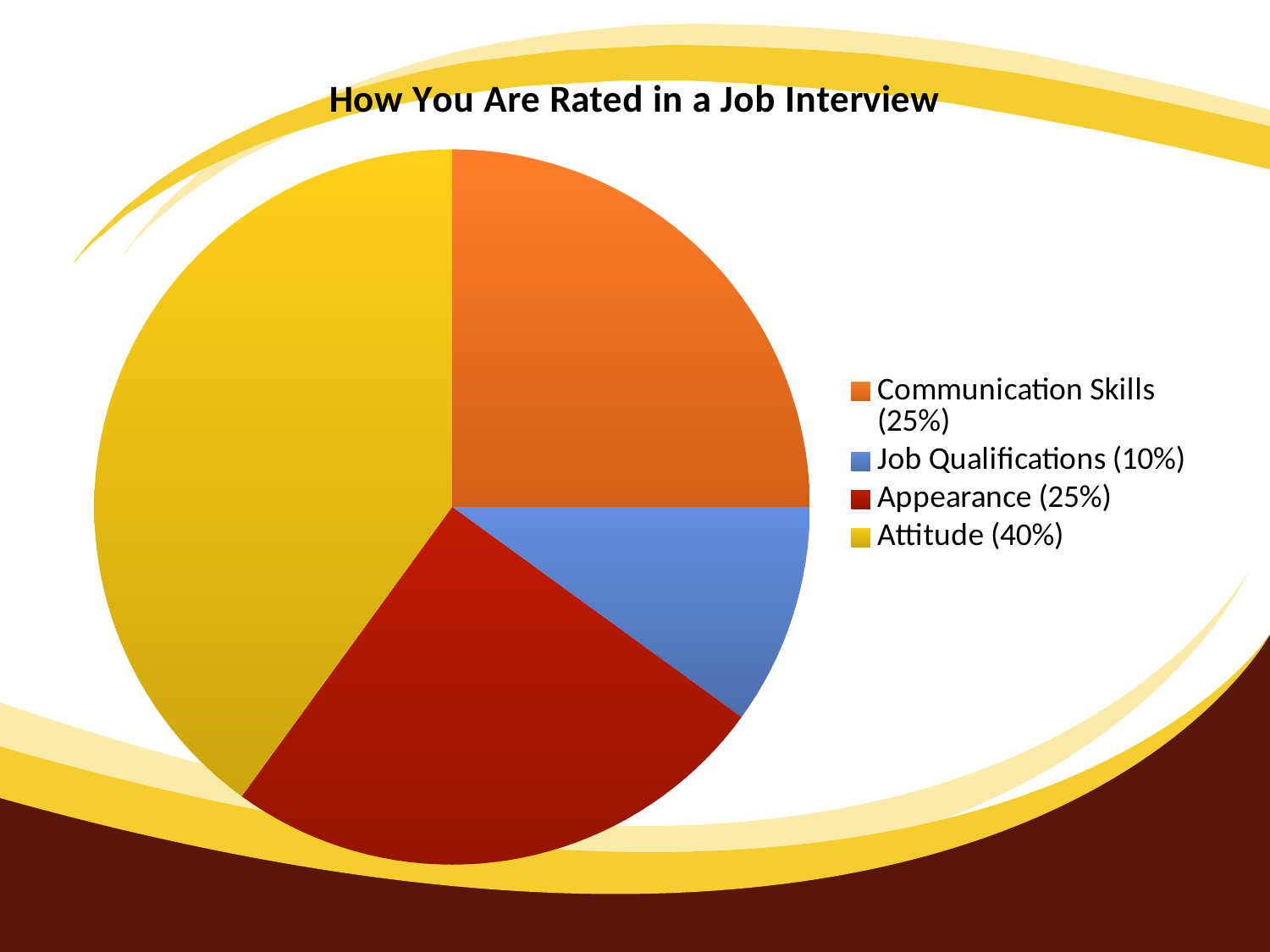
What is the title of the chart? How You Are Rated in a Job Interview How many slices does the pie chart have? 4 What type of chart is shown on the slide? Pie chart What is the difference in percentage points between Attitude and Job Qualifications? 30 Which category has the largest share of the pie? Attitude What colour is the slice for Attitude? Yellow What percentage is shown for Communication Skills? 25% What percentage is shown for Attitude? 40% What is the combined share of Communication Skills and Appearance? 50% Which category has the smallest share of the pie? Job Qualifications Which is larger, the share for Appearance or the share for Job Qualifications? Appearance What percentage is shown for Job Qualifications? 10%